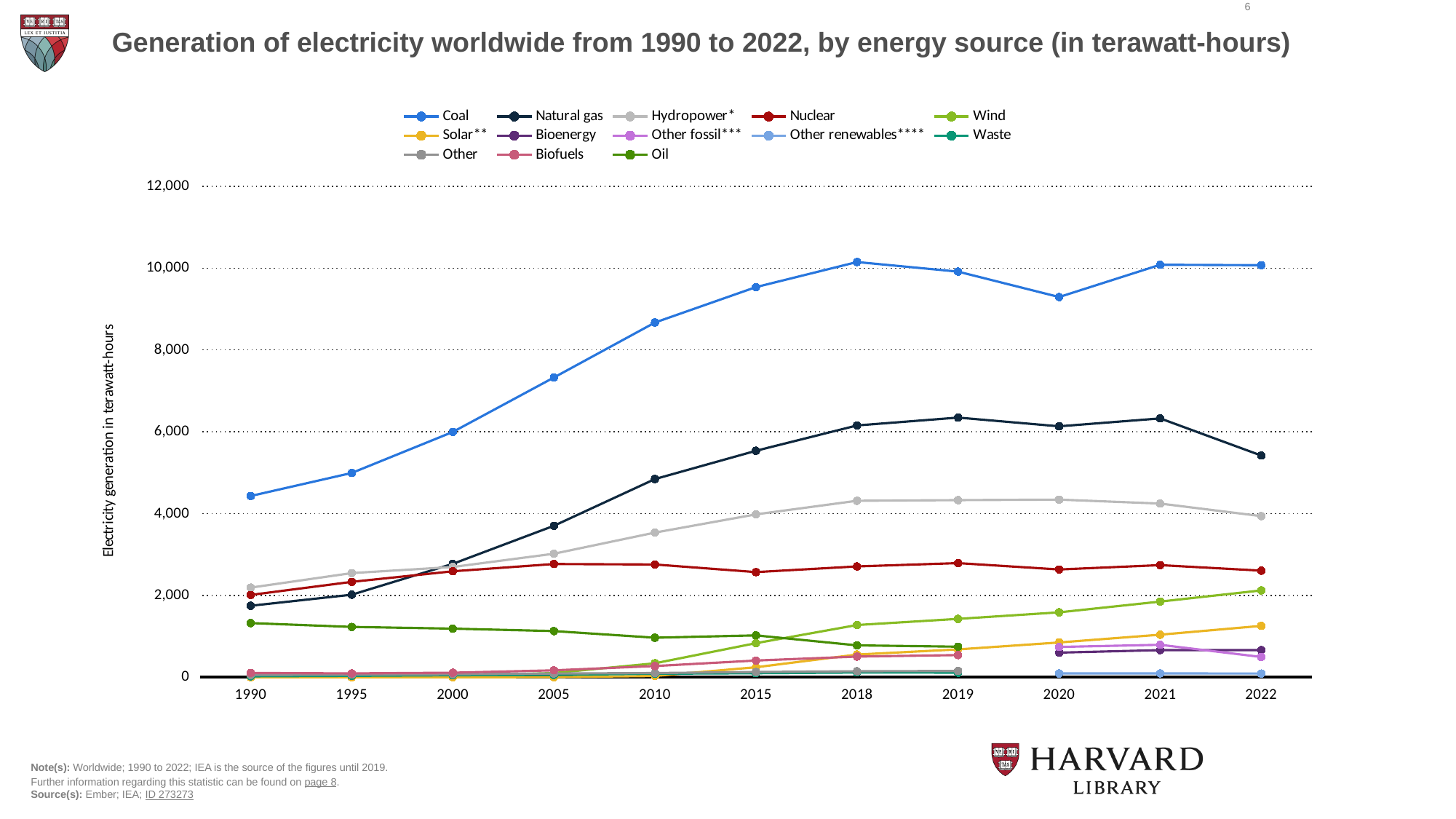
Is the value for Wind in 2021 greater or less than 2,000? less Which energy source has the highest electricity generation in 2022? Coal How many energy sources does the legend list? 13 Is the value for Coal in 2018 greater or less than 10,000? greater Is the value for Natural gas in 2022 greater or less than 6,000? less What kind of chart is shown on the slide? Line chart In 2022, which is larger: Natural gas or Hydropower? Natural gas Does the Coal line rise or fall between 1990 and 2018? Rises What is the label of the y axis? Electricity generation in terawatt-hours How many years are plotted along the x axis? 11